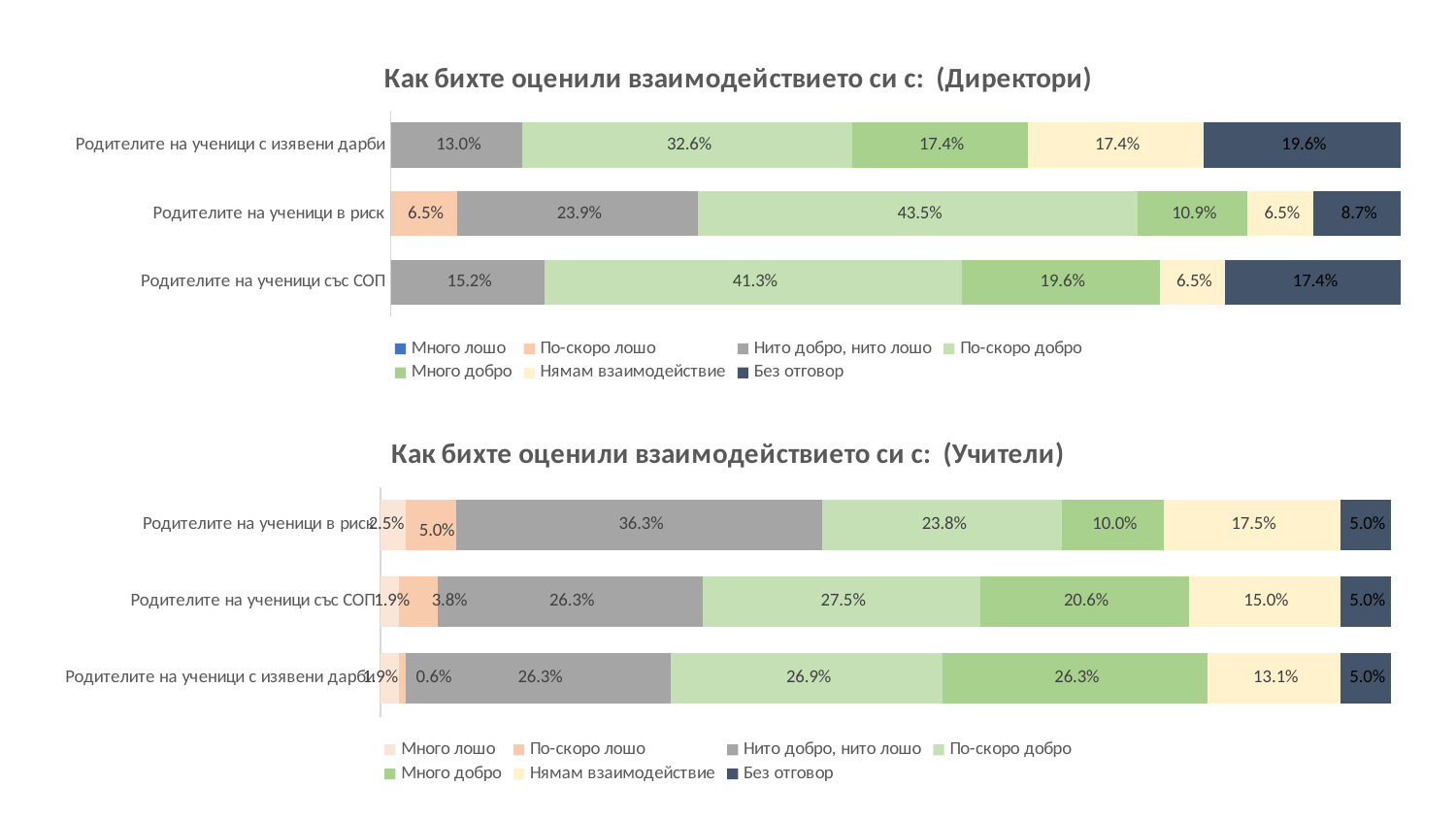
In the chart titled "Как бихте оценили взаимодействието си с: (Директори)", what is the value of "Без отговор" for "Родителите на ученици с изявени дарби"? 19.6% In the chart titled "Как бихте оценили взаимодействието си с: (Учители)", which category has the lowest value for "Много добро"? Родителите на ученици в риск In the chart titled "Как бихте оценили взаимодействието си с: (Учители)", how many categories are shown? 3 In the chart titled "Как бихте оценили взаимодействието си с: (Учители)", what is the value of "Нито добро, нито лошо" for "Родителите на ученици в риск"? 36.3% What kind of chart is the chart titled "Как бихте оценили взаимодействието си с: (Учители)"? Stacked bar chart In the chart titled "Как бихте оценили взаимодействието си с: (Учители)", what is the value of "Без отговор" for "Родителите на ученици с изявени дарби"? 5.0% In the chart titled "Как бихте оценили взаимодействието си с: (Учители)", what is the value of "Нямам взаимодействие" for "Родителите на ученици със СОП"? 15.0% In the chart titled "Как бихте оценили взаимодействието си с: (Директори)", which category has the highest value for "По-скоро добро"? Родителите на ученици в риск In the chart titled "Как бихте оценили взаимодействието си с: (Директори)", what is the value of "По-скоро добро" for "Родителите на ученици в риск"? 43.5% In the chart titled "Как бихте оценили взаимодействието си с: (Директори)", how many series does the legend list? 7 In the chart titled "Как бихте оценили взаимодействието си с: (Директори)", what is the difference between "Много добро" for "Родителите на ученици със СОП" and for "Родителите на ученици в риск"? 8.7% In the chart titled "Как бихте оценили взаимодействието си с: (Учители)", is "По-скоро добро" larger for "Родителите на ученици със СОП" or for "Родителите на ученици в риск"? Родителите на ученици със СОП